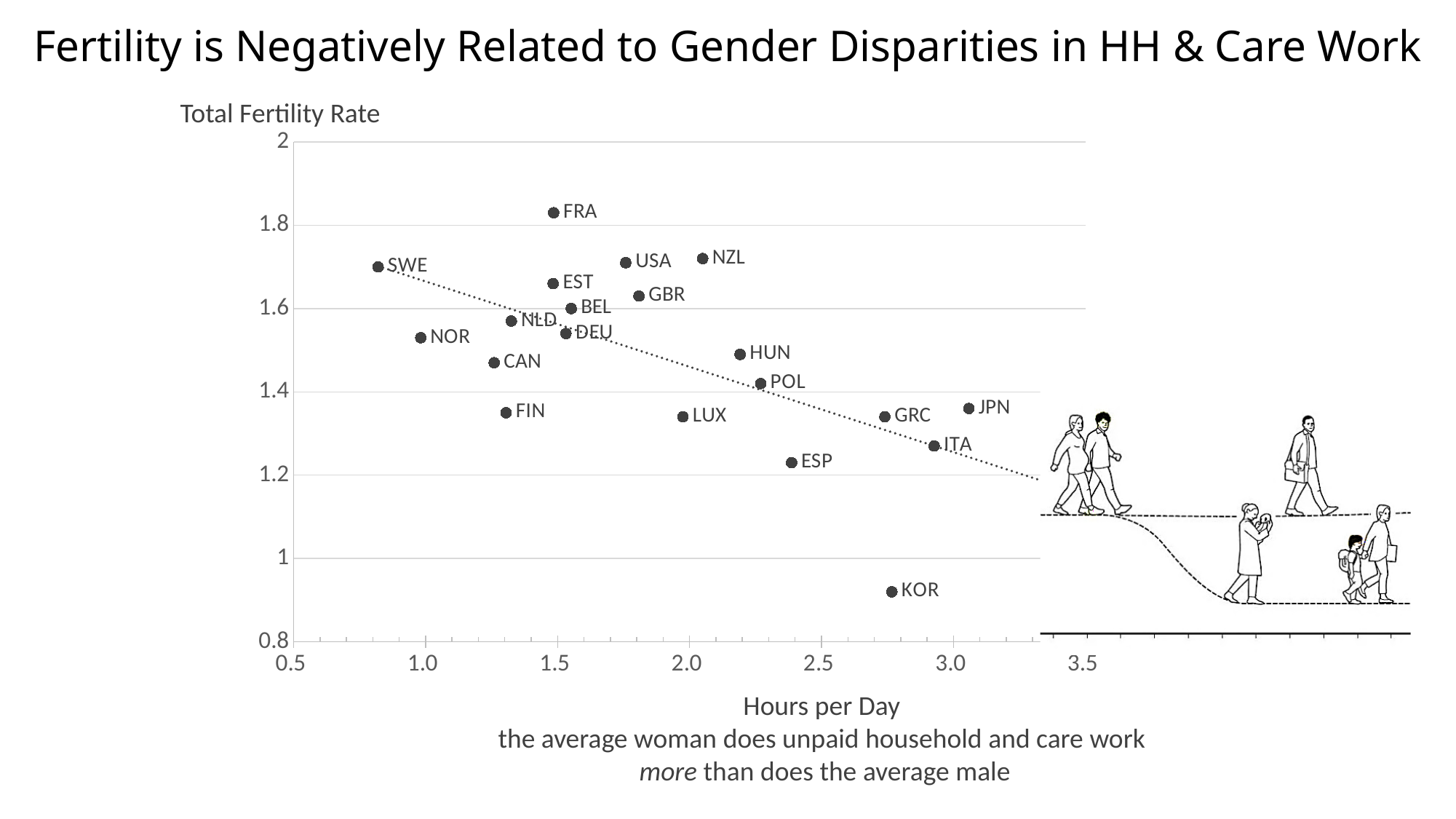
Which country has the highest value on the Hours per Day axis? JPN Is the Total Fertility Rate for FRA greater or less than 1.8? greater As Hours per Day increases along the x axis, does the Total Fertility Rate generally rise or fall? Fall How many countries are plotted on the chart? 20 Which country has the lowest value on the Hours per Day axis? SWE What kind of chart is shown on the slide? Scatter chart Which country has the highest Total Fertility Rate on the chart? FRA Which has the higher Total Fertility Rate, HUN or POL? HUN Is the Total Fertility Rate for KOR greater or less than 1? less Is the Hours per Day value for JPN greater or less than 3.0? greater Which has the higher Total Fertility Rate, CAN or FIN? CAN Which country has the lowest Total Fertility Rate on the chart? KOR